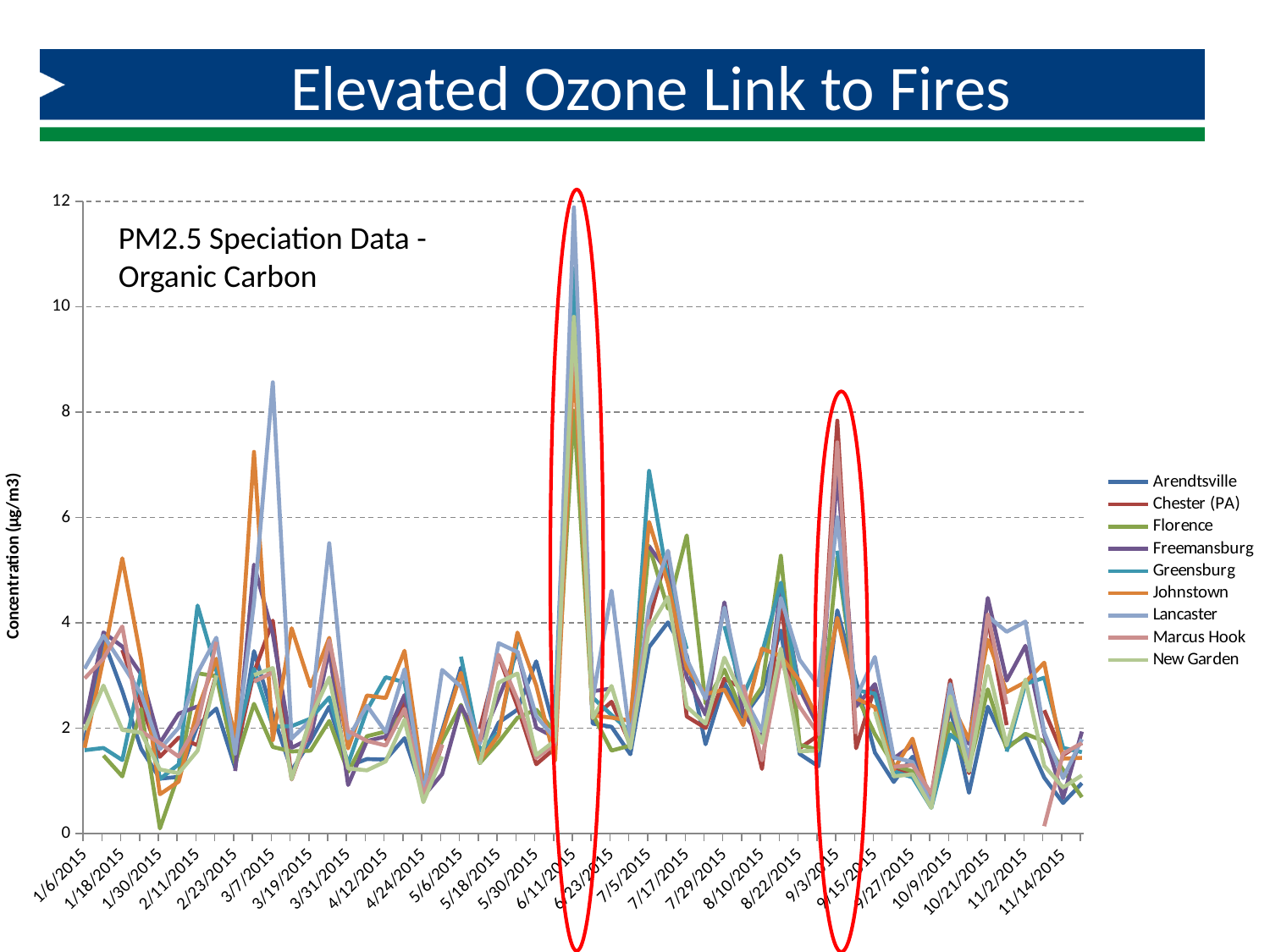
What is the label on the y axis of the chart? Concentration (µg/m3) What is the highest value shown on the y axis? 12 What title text is printed inside the chart area? PM2.5 Speciation Data - Organic Carbon Is the highest value in the second circled region, near 9/3/2015, greater or less than 6? greater Is the peak of the Johnstown series near 1/18/2015 greater or less than 4? greater Which series reaches the highest value anywhere on the chart? Lancaster What is the last date label on the x axis? 11/14/2015 Is the peak of the Lancaster series near 3/7/2015 greater or less than 8? greater What kind of chart is shown on the slide? line chart What is the first date label on the x axis? 1/6/2015 How many series does the legend list? 9